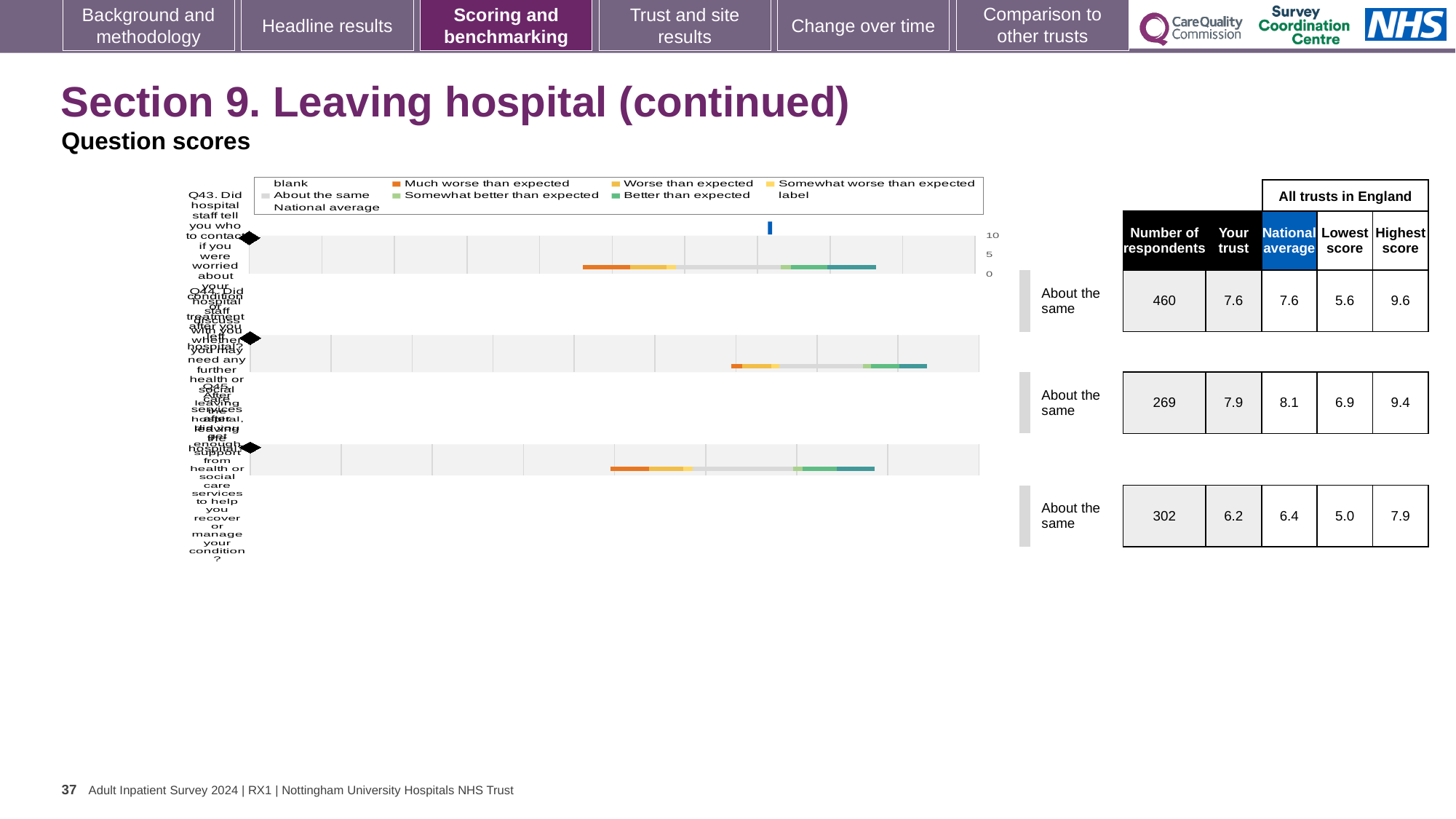
Which of the three charts has the lowest 'Your trust' score? the bottom chart (Q45) What is the 'Your trust' score for the middle chart (Q44)? 7.9 What is the difference between the national average and the 'Your trust' score for the bottom chart (Q45)? 0.2 What is the national average for the top chart (Q43)? 7.6 What is the highest score across all trusts in England for the bottom chart (Q45)? 7.9 Is the 'Your trust' score for the middle chart (Q44) larger or smaller than its national average? smaller How many respondents are listed for the middle chart (Q44)? 269 What benchmark category is shown next to each of the three charts? About the same How many question-score charts are shown on the slide? 3 What is the maximum value shown on the score axis of the charts? 10 What is the 'Your trust' score for the top chart (Q43)? 7.6 What kind of chart is used for the question scores on this slide? bar chart